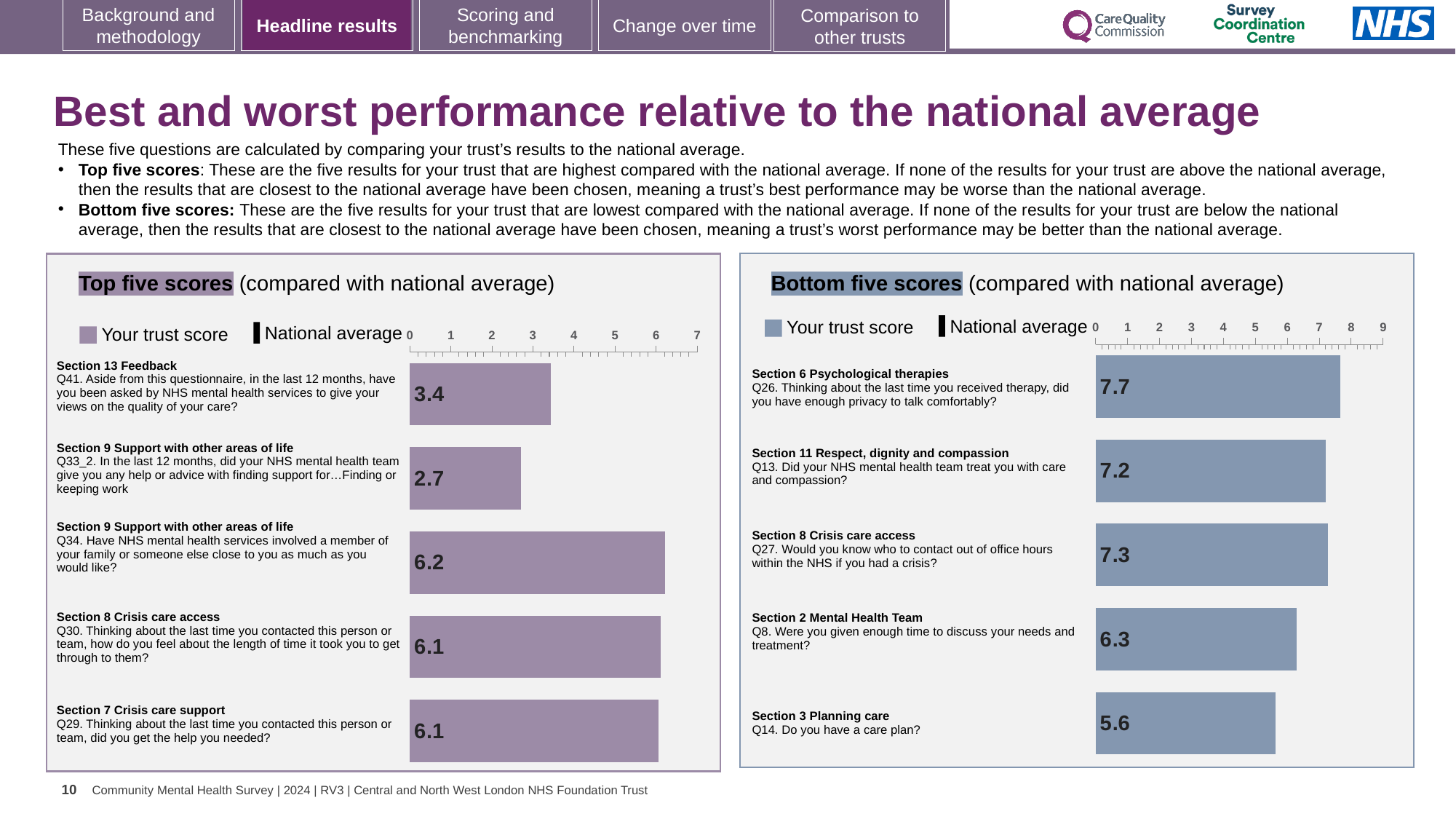
In the Bottom five scores chart, which has the larger trust score: Q13 or Q27? Q27 How many questions are plotted in the Top five scores chart? 5 In the Top five scores chart, what is the trust score for Q41 (asked to give views on the quality of your care)? 3.4 In the Bottom five scores chart, which question has the lowest trust score? Q14 In the Top five scores chart, what is the trust score for Q34 (involving family or someone close as much as you would like)? 6.2 In the Bottom five scores chart, which question has the highest trust score? Q26 In the Top five scores chart, which question has the lowest trust score? Q33_2 (help finding or keeping work) In the Bottom five scores chart, what is the trust score for Q14 (Do you have a care plan?)? 5.6 In the Top five scores chart, which question has the highest trust score? Q34 In the Bottom five scores chart, what is the trust score for Q26 (enough privacy to talk comfortably during therapy)? 7.7 In the Top five scores chart, what is the difference between the trust scores for Q34 and Q33_2? 3.5 In the Bottom five scores chart, what is the difference between the trust scores for Q26 and Q8? 1.4